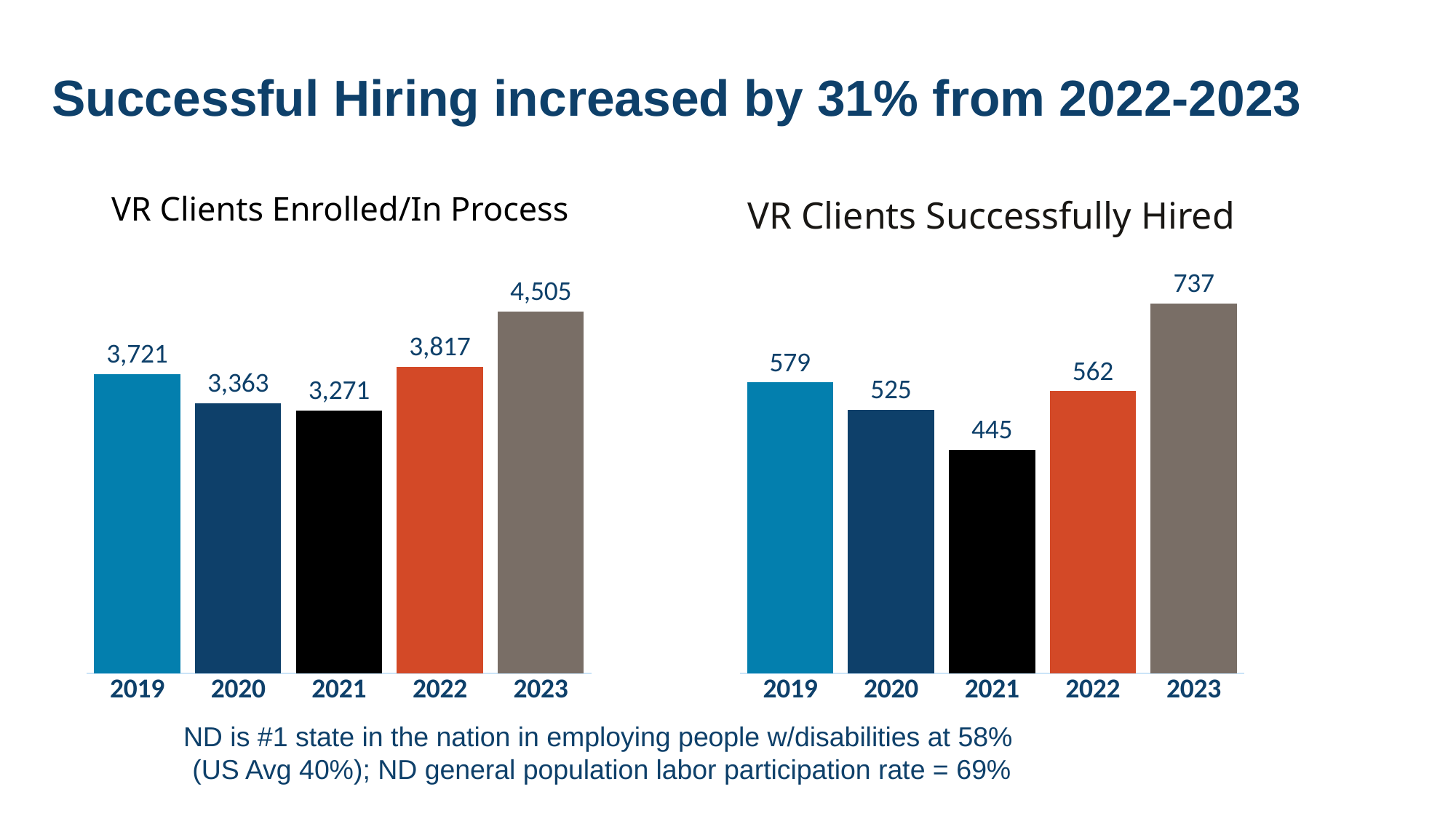
In the 'VR Clients Successfully Hired' chart, which is larger, the value for 2019 or the value for 2020? 2019 In the 'VR Clients Successfully Hired' chart, which year has the lowest value? 2021 In the 'VR Clients Enrolled/In Process' chart, do the values rise or fall from 2021 to 2023? Rise In the 'VR Clients Successfully Hired' chart, what is the difference between the 2023 and 2022 values? 175 In the 'VR Clients Enrolled/In Process' chart, what is the difference between the 2019 and 2020 values? 358 In the 'VR Clients Enrolled/In Process' chart, what is the value for 2021? 3,271 What kind of chart is the 'VR Clients Enrolled/In Process' chart? Bar chart In the 'VR Clients Successfully Hired' chart, what is the value for 2022? 562 In the 'VR Clients Enrolled/In Process' chart, which year has the highest value? 2023 How many years are shown in the 'VR Clients Successfully Hired' chart? 5 In the 'VR Clients Enrolled/In Process' chart, which is larger, the value for 2021 or the value for 2022? 2022 What is the title of the chart on the right side of the slide? VR Clients Successfully Hired